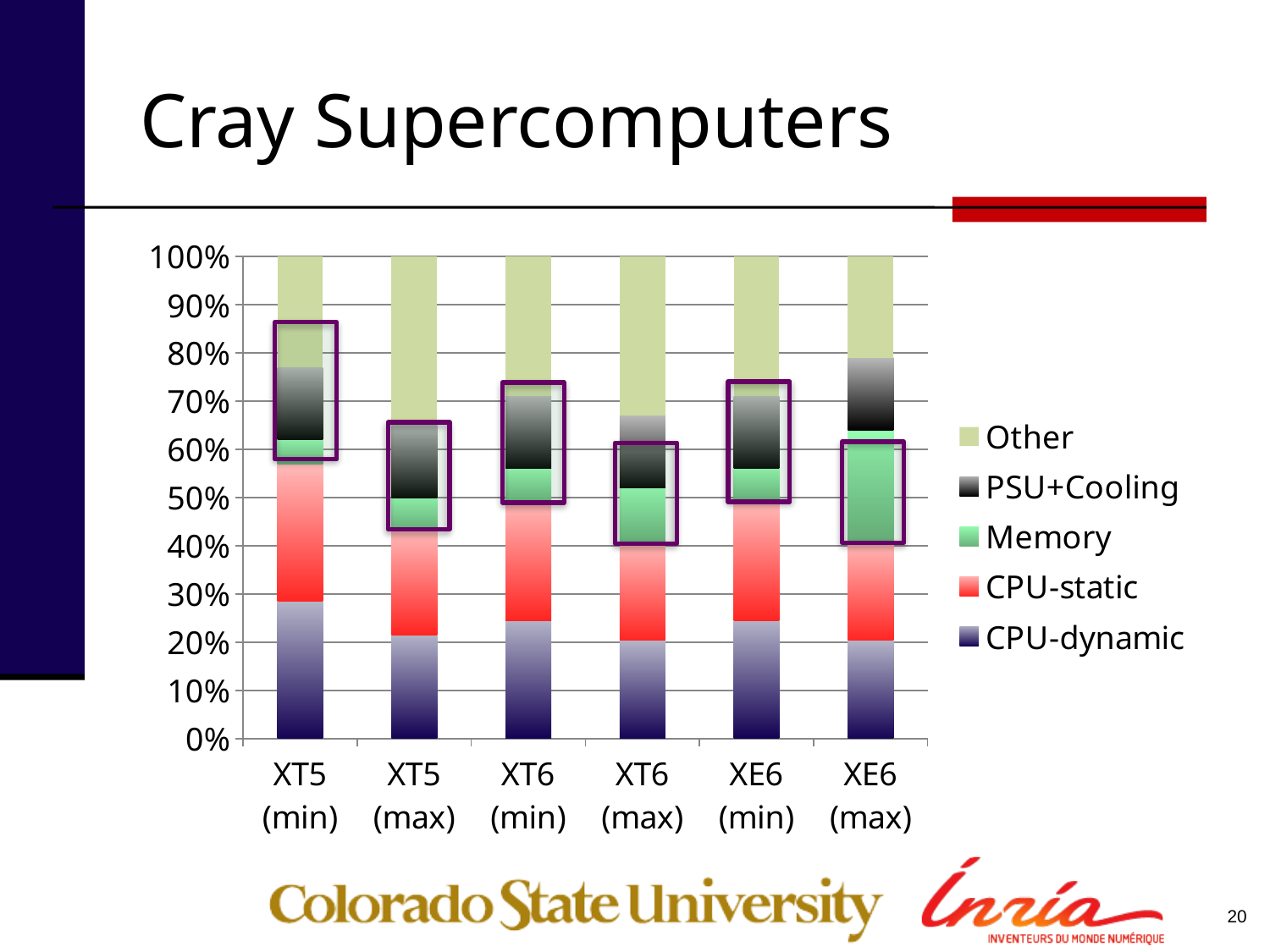
Which series is at the bottom of each stacked bar? CPU-dynamic What kind of chart is shown on the slide? Stacked bar chart Is the CPU-dynamic share for XT5 (min) greater or less than 20%? greater How many series does the legend list? 5 Which bar has the largest CPU-dynamic share? XT5 (min) Is the CPU-dynamic share larger for XT5 (min) or for XT5 (max)? XT5 (min) How many bars (system configurations) are plotted on the x axis? 6 What colour represents the Memory series in the legend? Green Is the Memory share larger for XE6 (max) or for XT5 (min)? XE6 (max) Which bar has the largest Memory share? XE6 (max) Is the Other share for XT5 (max) greater or less than 30%? greater Is the CPU-dynamic share for XE6 (max) greater or less than 30%? less